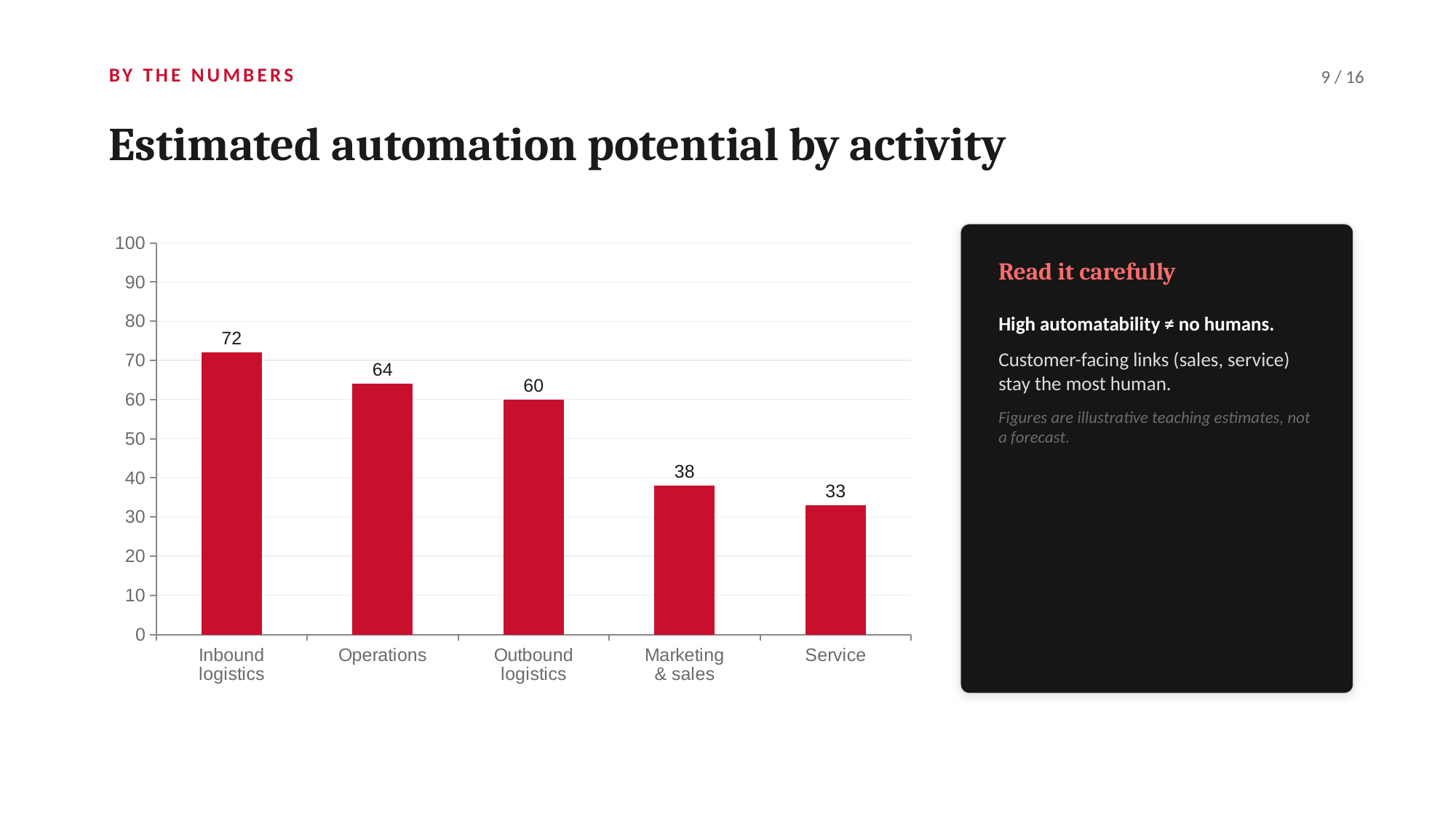
How many activities are shown on the chart? 5 Which has a higher value, Outbound logistics or Marketing & sales? Outbound logistics Which activity has the lowest estimated automation potential? Service Do the values rise or fall from left to right across the activities? Fall What is the value shown for Operations? 64 What is the difference between the values for Inbound logistics and Service? 39 What is the estimated automation potential for Inbound logistics? 72 What is the value shown for Marketing & sales? 38 What is the difference between the values for Operations and Outbound logistics? 4 What kind of chart is shown on the slide? Bar chart Which activity has the highest estimated automation potential? Inbound logistics What is the value shown for Service? 33